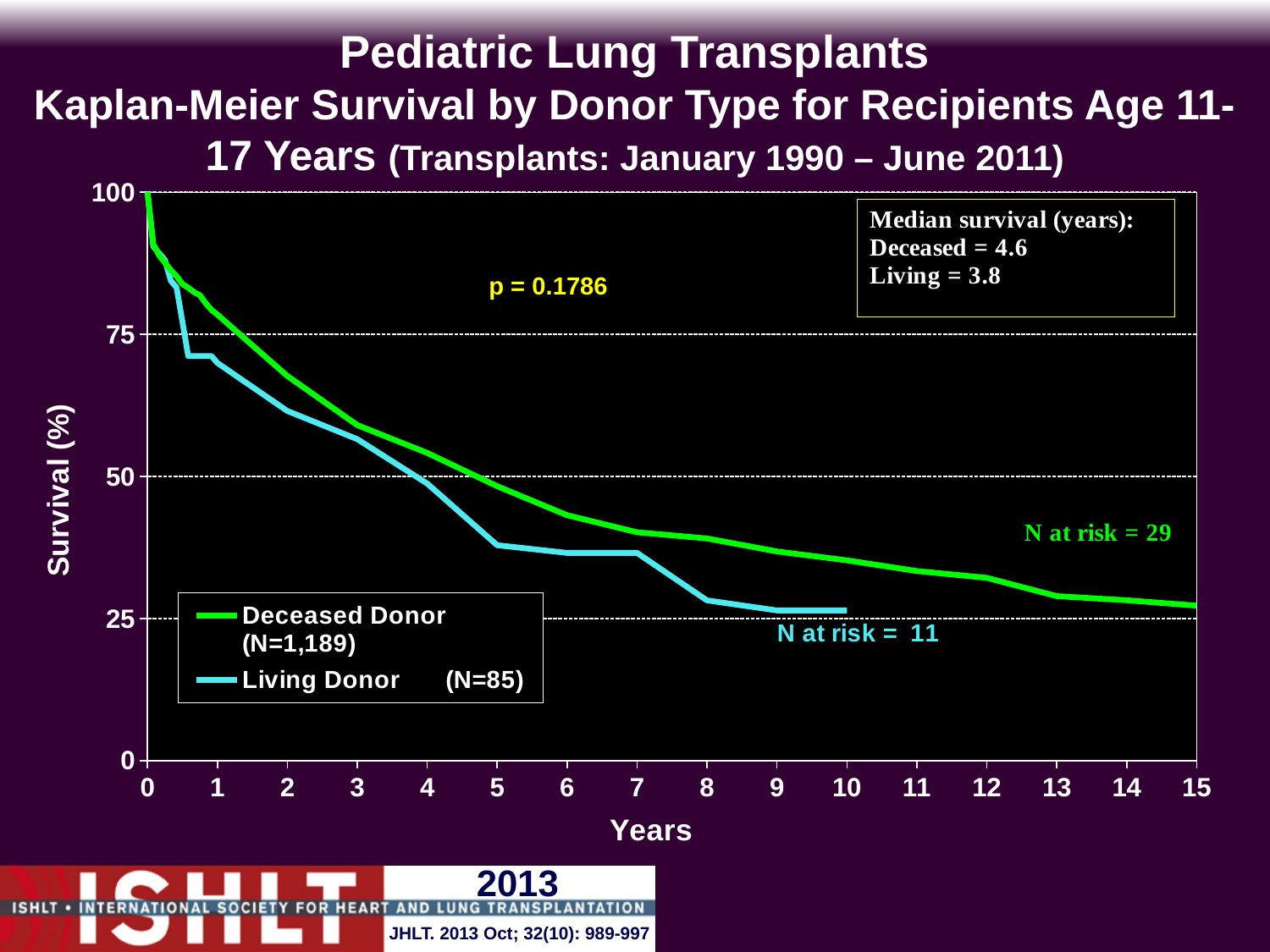
How many series does the legend list? 2 Is the Deceased Donor survival at 15 years greater or less than 25%? greater What is the difference in median survival (years) between the Deceased Donor and Living Donor groups? 0.8 Is the Living Donor survival at 5 years greater or less than 50%? less What is the N at risk for the Living Donor curve? 11 What is the median survival in years for the Living Donor group? 3.8 Do the survival curves rise or fall as years increase? fall What is the N at risk for the Deceased Donor curve? 29 Which donor group has the higher median survival? Deceased Donor What is the median survival in years for the Deceased Donor group? 4.6 What kind of chart is shown on the slide? line chart What is the p-value shown on the chart? p = 0.1786